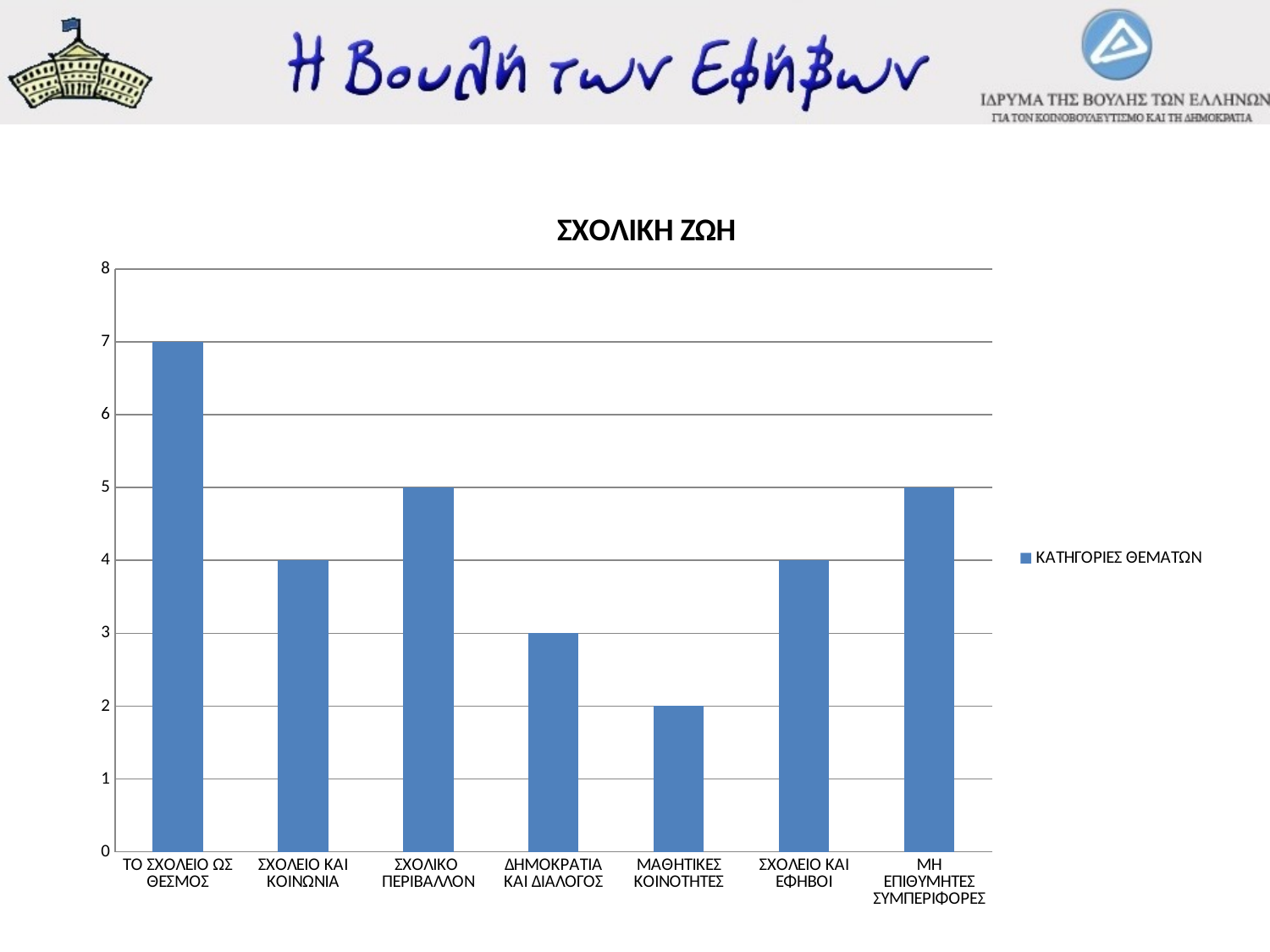
What is the value for ΤΟ ΣΧΟΛΕΙΟ ΩΣ ΘΕΣΜΟΣ? 7 Is the value for ΣΧΟΛΕΙΟ ΚΑΙ ΕΦΗΒΟΙ greater or less than 6? less What is the difference between the values for ΤΟ ΣΧΟΛΕΙΟ ΩΣ ΘΕΣΜΟΣ and ΣΧΟΛΙΚΟ ΠΕΡΙΒΑΛΛΟΝ? 2 What kind of chart is shown on the slide? bar chart Which category has the lowest value? ΜΑΘΗΤΙΚΕΣ ΚΟΙΝΟΤΗΤΕΣ How many categories are shown on the x axis? 7 What is the value for ΔΗΜΟΚΡΑΤΙΑ ΚΑΙ ΔΙΑΛΟΓΟΣ? 3 Which is larger, the value for ΣΧΟΛΕΙΟ ΚΑΙ ΚΟΙΝΩΝΙΑ or the value for ΜΗ ΕΠΙΘΥΜΗΤΕΣ ΣΥΜΠΕΡΙΦΟΡΕΣ? ΜΗ ΕΠΙΘΥΜΗΤΕΣ ΣΥΜΠΕΡΙΦΟΡΕΣ How many series does the legend list? 1 Which category has the highest value? ΤΟ ΣΧΟΛΕΙΟ ΩΣ ΘΕΣΜΟΣ What is the value for ΜΑΘΗΤΙΚΕΣ ΚΟΙΝΟΤΗΤΕΣ? 2 What is the title of the chart? ΣΧΟΛΙΚΗ ΖΩΗ